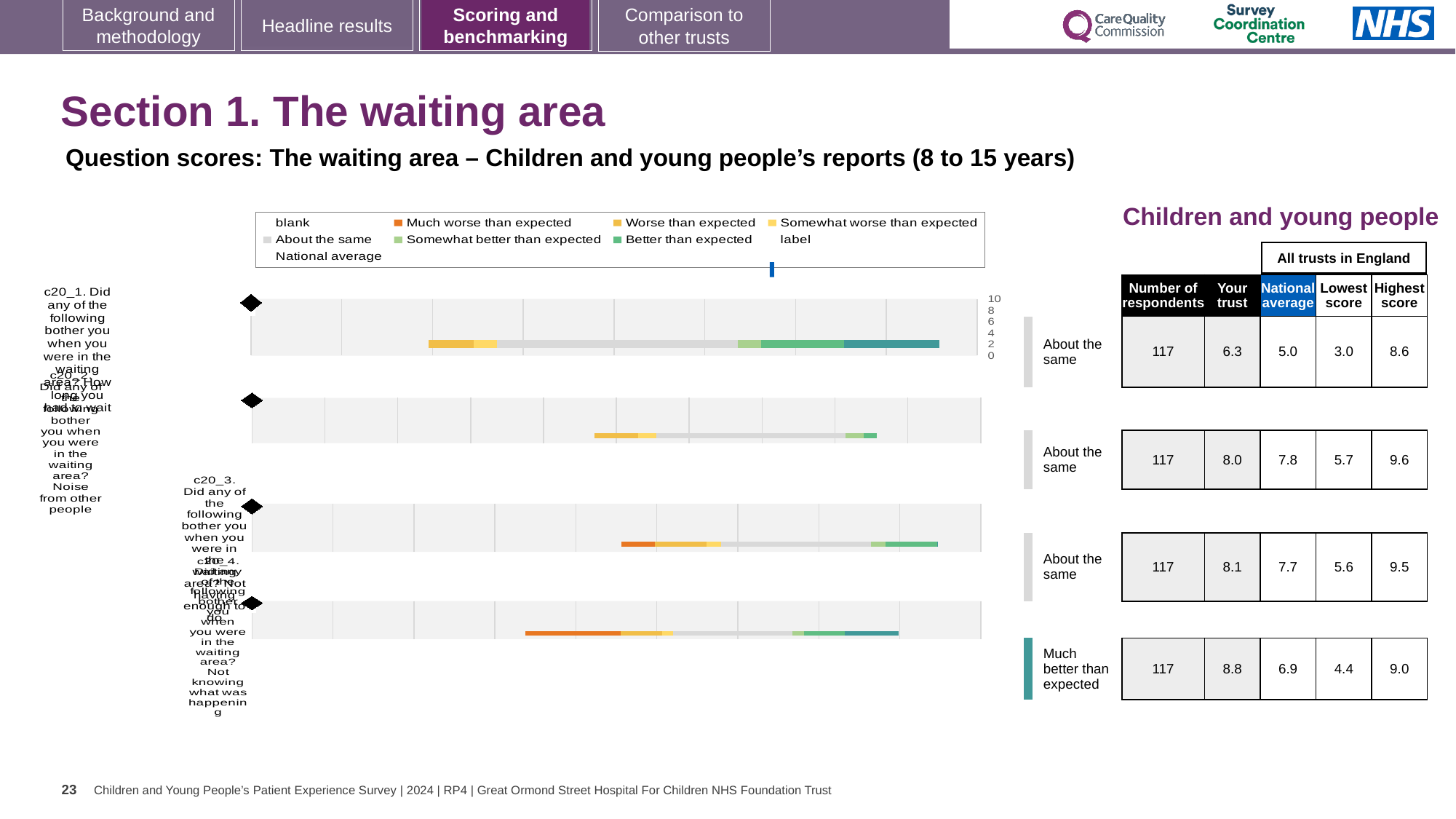
How many entries does the legend of the waiting area chart list? 9 What is the 'Your trust' score for the fourth (bottom) question, c20_4 about not knowing what was happening? 8.8 How many respondents answered the first question, c20_1? 117 Which question has the highest 'Your trust' score? c20_4 (Not knowing what was happening), 8.8 What is the national average for the second question, c20_2 about noise from other people? 7.8 Is the 'Your trust' score higher for the third question (c20_3) or the second question (c20_2)? c20_3 (8.1) For the fourth question (c20_4), how much higher is the 'Your trust' score than the national average? 1.9 What is the highest score among all trusts in England for the first question, c20_1? 8.6 How many questions (bars) are plotted in the waiting area chart? 4 Which question has the lowest 'Your trust' score? c20_1 (How long you had to wait), 6.3 What benchmark rating is given to the fourth question, c20_4? Much better than expected What kind of chart is used to show the question scores for the waiting area? Bar chart